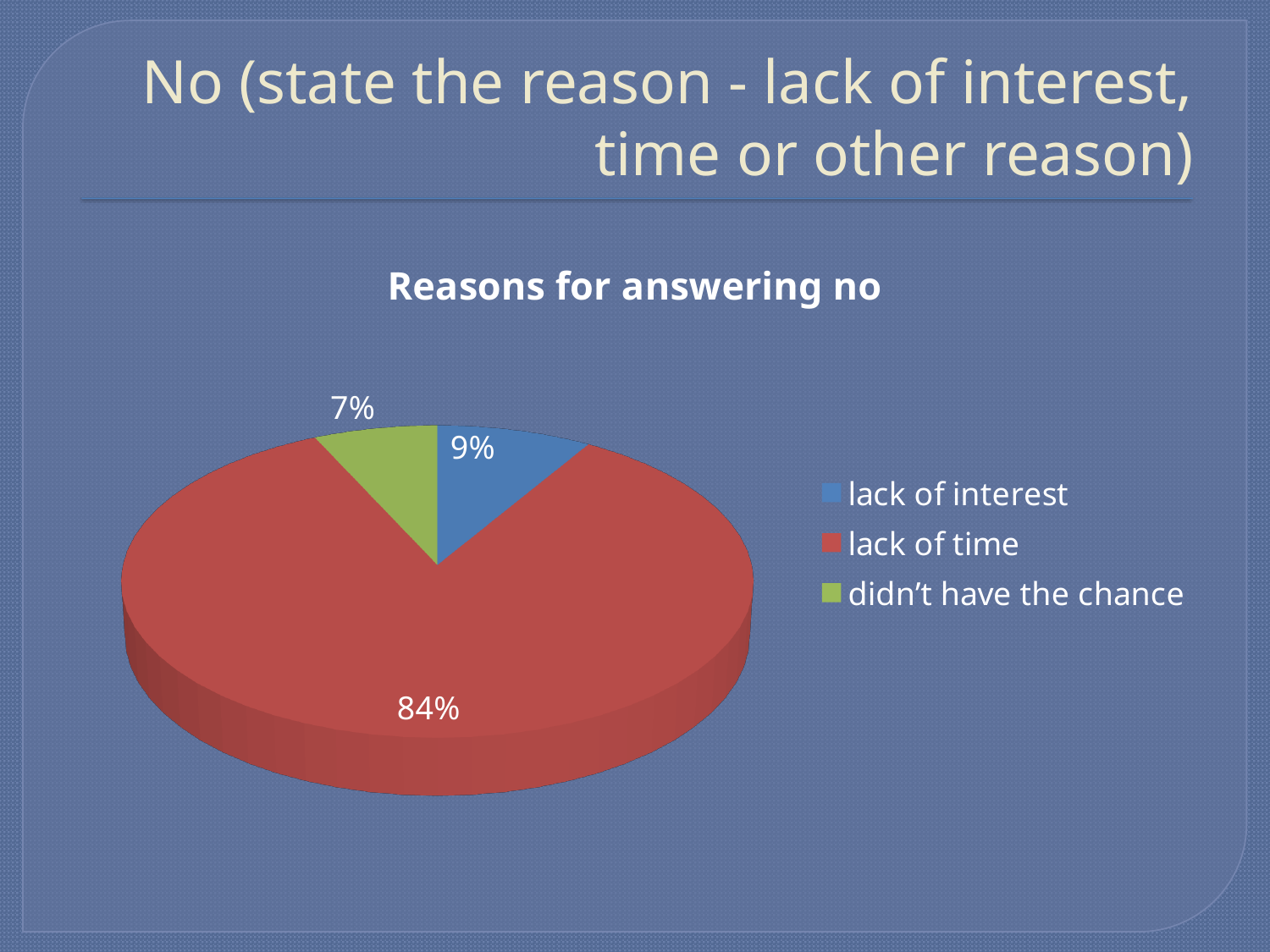
What share of the pie is 'lack of time'? 84% How many categories does the pie chart have? 3 Which reason has the largest share of the pie? lack of time What is the difference in percentage points between 'lack of time' and 'lack of interest'? 75 What share of the pie is 'lack of interest'? 9% What colour is the slice for 'lack of time'? red What is the title of the chart? Reasons for answering no What share of the pie is 'didn't have the chance'? 7% What kind of chart is shown on the slide? pie chart What is the difference in percentage points between 'lack of interest' and 'didn't have the chance'? 2 Which is larger, the share for 'lack of interest' or the share for 'didn't have the chance'? lack of interest Which reason has the smallest share of the pie? didn't have the chance